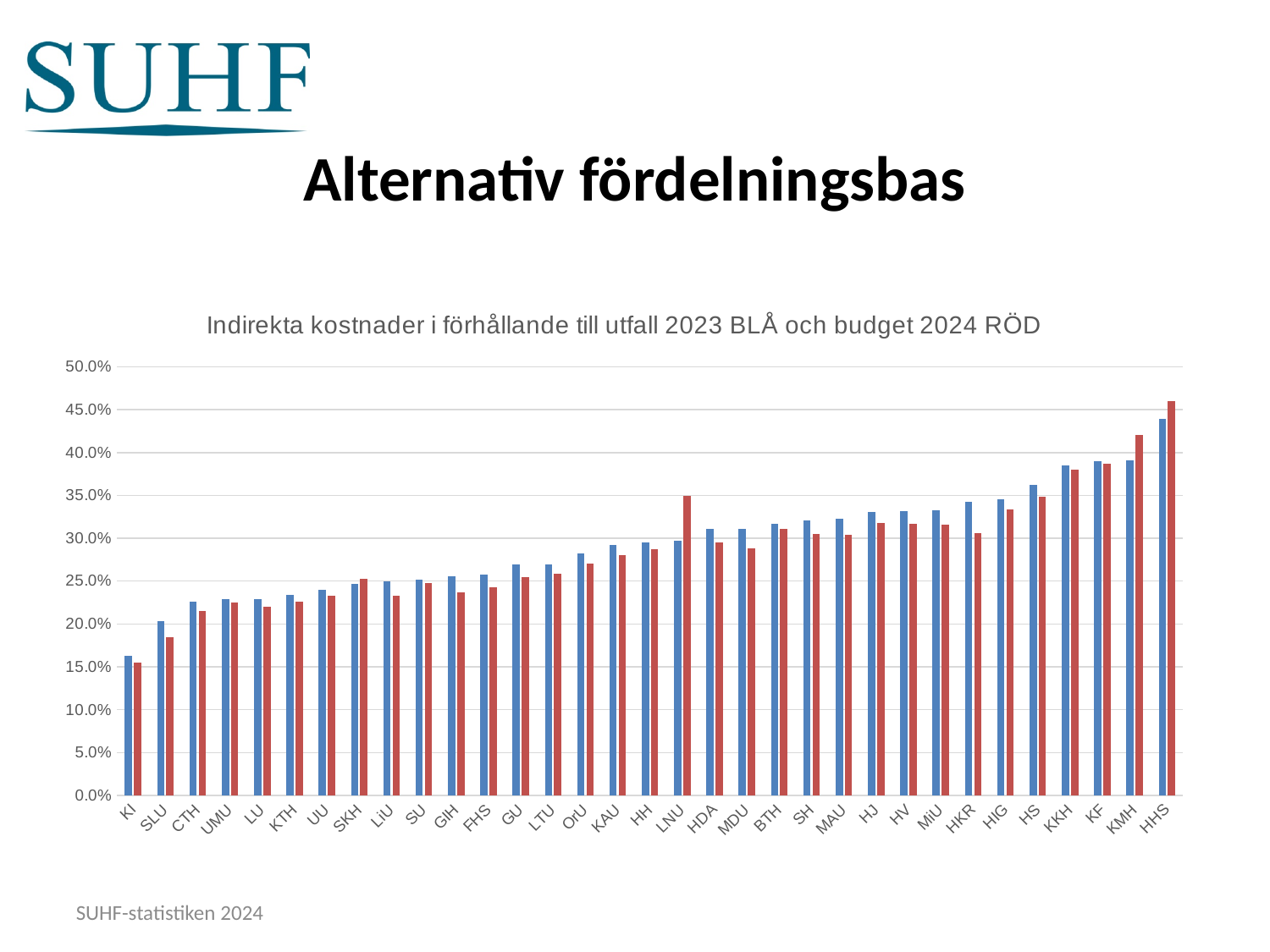
Which institution has the highest blue (utfall 2023) bar? HHS What kind of chart is shown on the slide? bar chart Do the blue (utfall 2023) bars generally rise or fall from left to right along the x axis? rise Is the blue (utfall 2023) value for HS greater or less than 35.0%? greater Which institution has the highest red (budget 2024) bar? HHS Is the red (budget 2024) value for SLU greater or less than 20.0%? less For LNU, which bar is taller: the blue (utfall 2023) or the red (budget 2024)? red (budget 2024) How many institutions (categories) are shown along the x axis of the chart? 33 For HKR, which bar is taller: the blue (utfall 2023) or the red (budget 2024)? blue (utfall 2023) What is the title of the chart? Indirekta kostnader i förhållande till utfall 2023 BLÅ och budget 2024 RÖD Is the red (budget 2024) value for HHS greater or less than 45.0%? greater Which institution has the lowest blue (utfall 2023) bar? KI